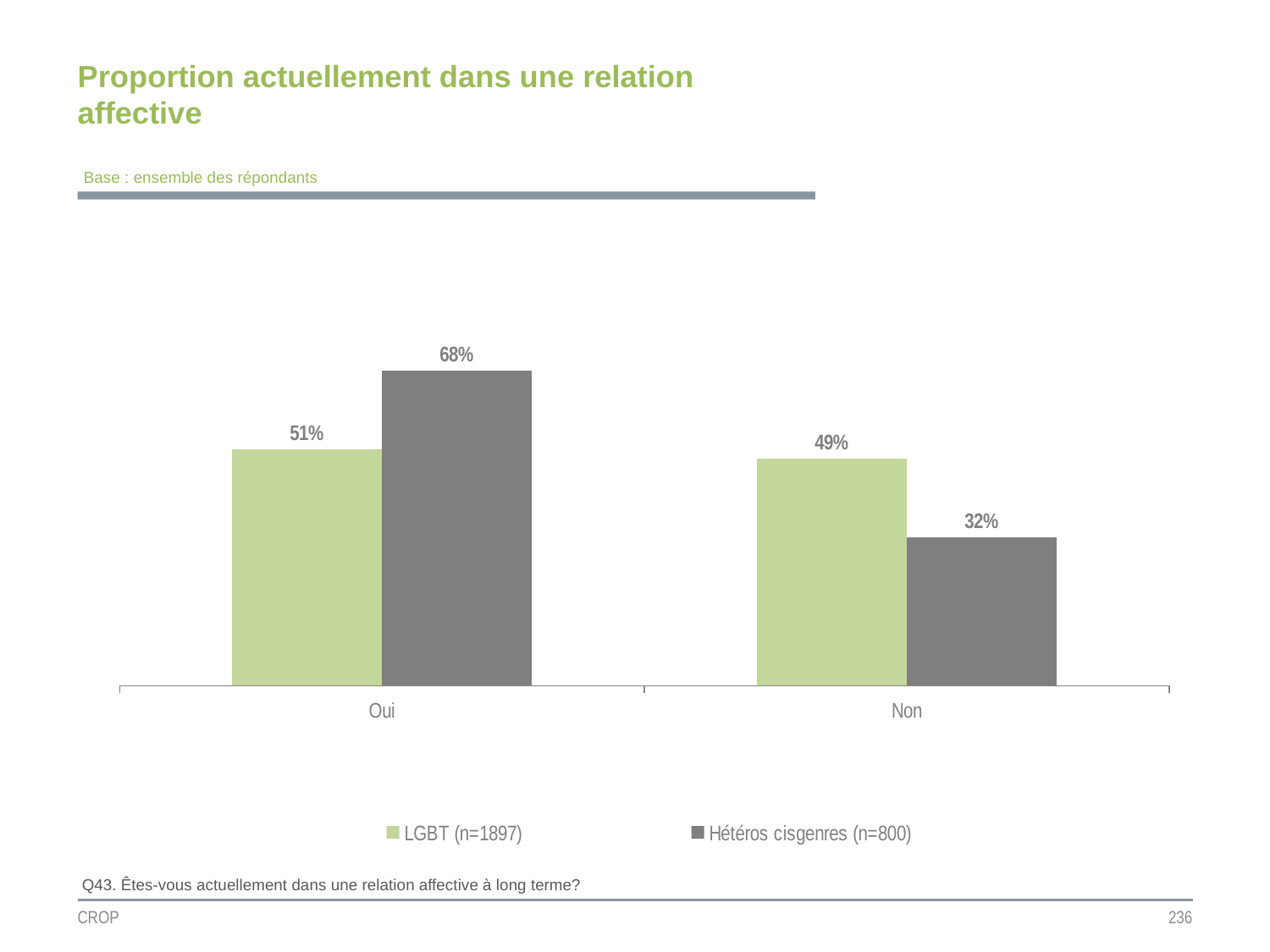
What is the difference between the LGBT and Hétéros cisgenres values for "Non"? 17 percentage points What percentage of LGBT respondents answered "Oui"? 51% What percentage of Hétéros cisgenres respondents answered "Non"? 32% Which bar has the lowest value on the chart? Hétéros cisgenres, Non (32%) Which group has the higher value for "Non"? LGBT (n=1897) What type of chart is shown on the slide? Bar chart Which group has the higher value for "Oui"? Hétéros cisgenres (n=800) How many categories are shown on the x axis? 2 What percentage of Hétéros cisgenres respondents answered "Oui"? 68% How many series does the legend list? 2 What is the difference between the Hétéros cisgenres and LGBT values for "Oui"? 17 percentage points What percentage of LGBT respondents answered "Non"? 49%